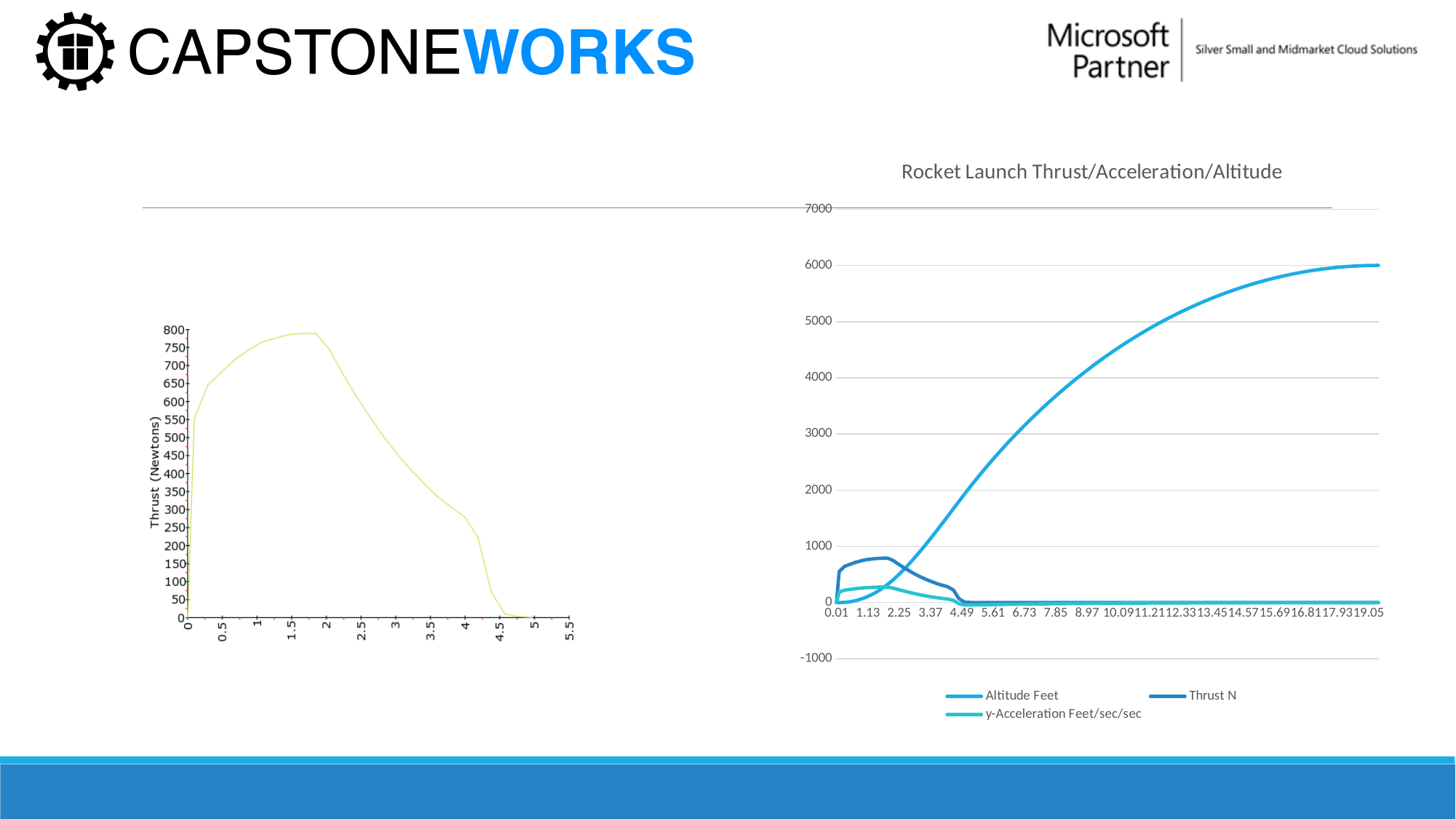
In the 'Rocket Launch Thrust/Acceleration/Altitude' chart, is the Altitude Feet value at 19.05 greater or less than 5000? greater What is the title of the chart on the right side of the slide? Rocket Launch Thrust/Acceleration/Altitude In the 'Rocket Launch Thrust/Acceleration/Altitude' chart, is the peak value of the Thrust N series greater or less than 1000? less What kind of chart is the chart on the left side of the slide? line chart In the chart on the left, is the thrust value at x = 3 greater or less than 500? less What kind of chart is the chart on the right titled 'Rocket Launch Thrust/Acceleration/Altitude'? line chart In the 'Rocket Launch Thrust/Acceleration/Altitude' chart, does the Altitude Feet series rise or fall along the x axis? rise How many series does the legend of the 'Rocket Launch Thrust/Acceleration/Altitude' chart list? 3 What is the y-axis label of the chart on the left side of the slide? Thrust (Newtons) In the 'Rocket Launch Thrust/Acceleration/Altitude' chart, which series reaches the highest value? Altitude Feet In the 'Rocket Launch Thrust/Acceleration/Altitude' chart, which series is larger at 10.09: Altitude Feet or Thrust N? Altitude Feet